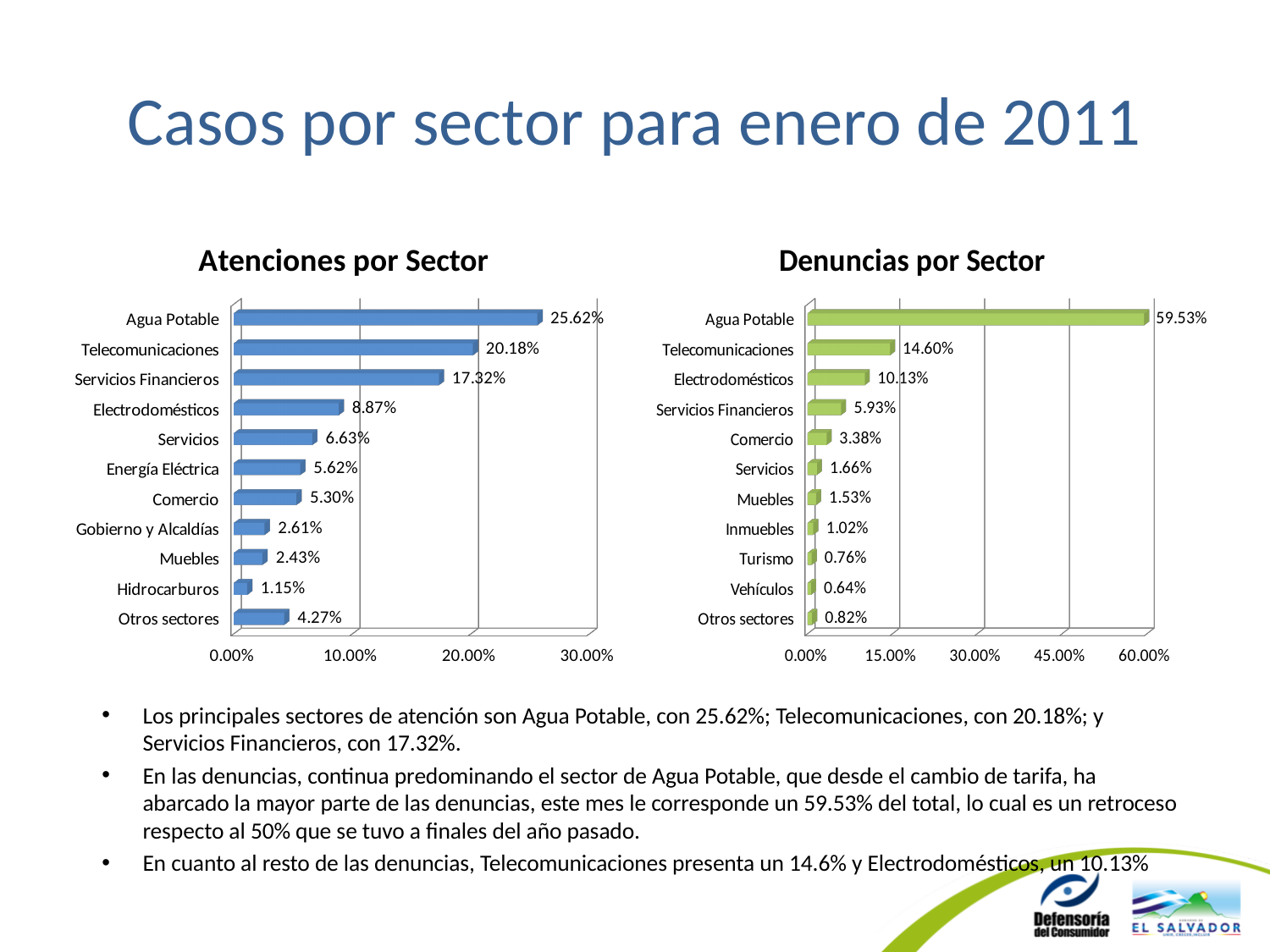
In the 'Denuncias por Sector' chart, which sector has the highest value? Agua Potable What type of chart is 'Denuncias por Sector'? Bar chart In the 'Denuncias por Sector' chart, what is the difference between Telecomunicaciones and Electrodomésticos? 4.47% In the 'Denuncias por Sector' chart, which sector has the lowest value? Vehículos In the 'Atenciones por Sector' chart, what is the value for Servicios Financieros? 17.32% In the 'Atenciones por Sector' chart, which is larger: Servicios or Comercio? Servicios How many sectors are shown in the 'Atenciones por Sector' chart? 11 What colour are the bars in the 'Denuncias por Sector' chart? Green In the 'Atenciones por Sector' chart, which sector has the lowest value? Hidrocarburos In the 'Atenciones por Sector' chart, what is the difference between Agua Potable and Telecomunicaciones? 5.44% In the 'Denuncias por Sector' chart, is the value for Agua Potable greater or less than 45.00%? greater In the 'Denuncias por Sector' chart, what is the value for Electrodomésticos? 10.13%